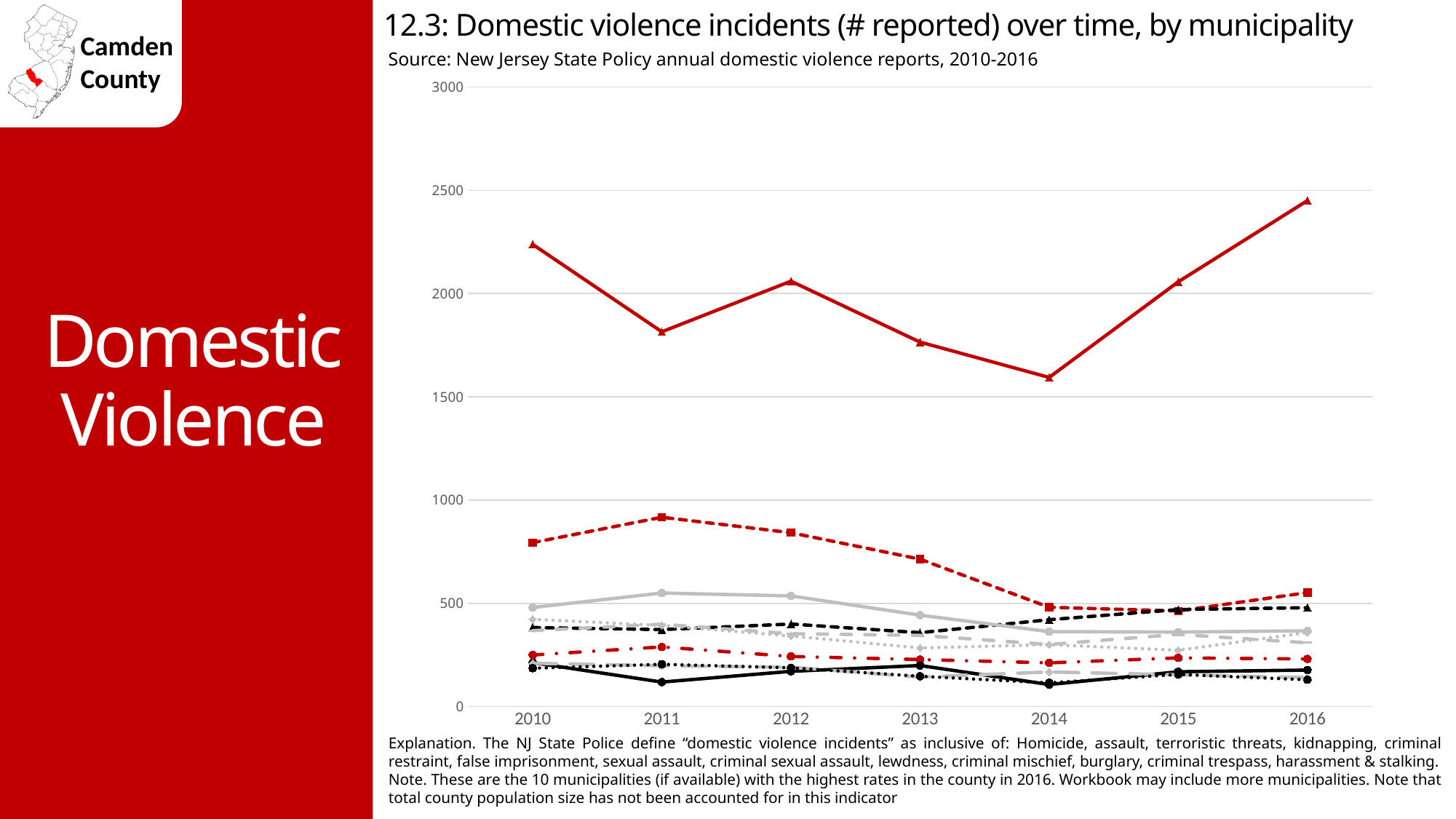
Does the dashed red line with square markers rise or fall from 2011 to 2014? fall In which year does the solid red line with triangle markers reach its lowest value? 2014 What kind of chart is shown on the slide? line chart Is the 2014 value of the solid red line with triangle markers greater or less than 2000? less Does the solid red line with triangle markers rise or fall from 2014 to 2016? rise In which year does the solid red line with triangle markers reach its highest value? 2016 Is the 2016 value of the solid red line with triangle markers greater or less than 2000? greater How many years are shown along the x axis of the chart? 7 Is the 2011 value of the dashed red line with square markers greater or less than 500? greater What is the title of the chart on the slide? 12.3: Domestic violence incidents (# reported) over time, by municipality For the solid red line with triangle markers, is the value higher in 2010 or in 2016? 2016